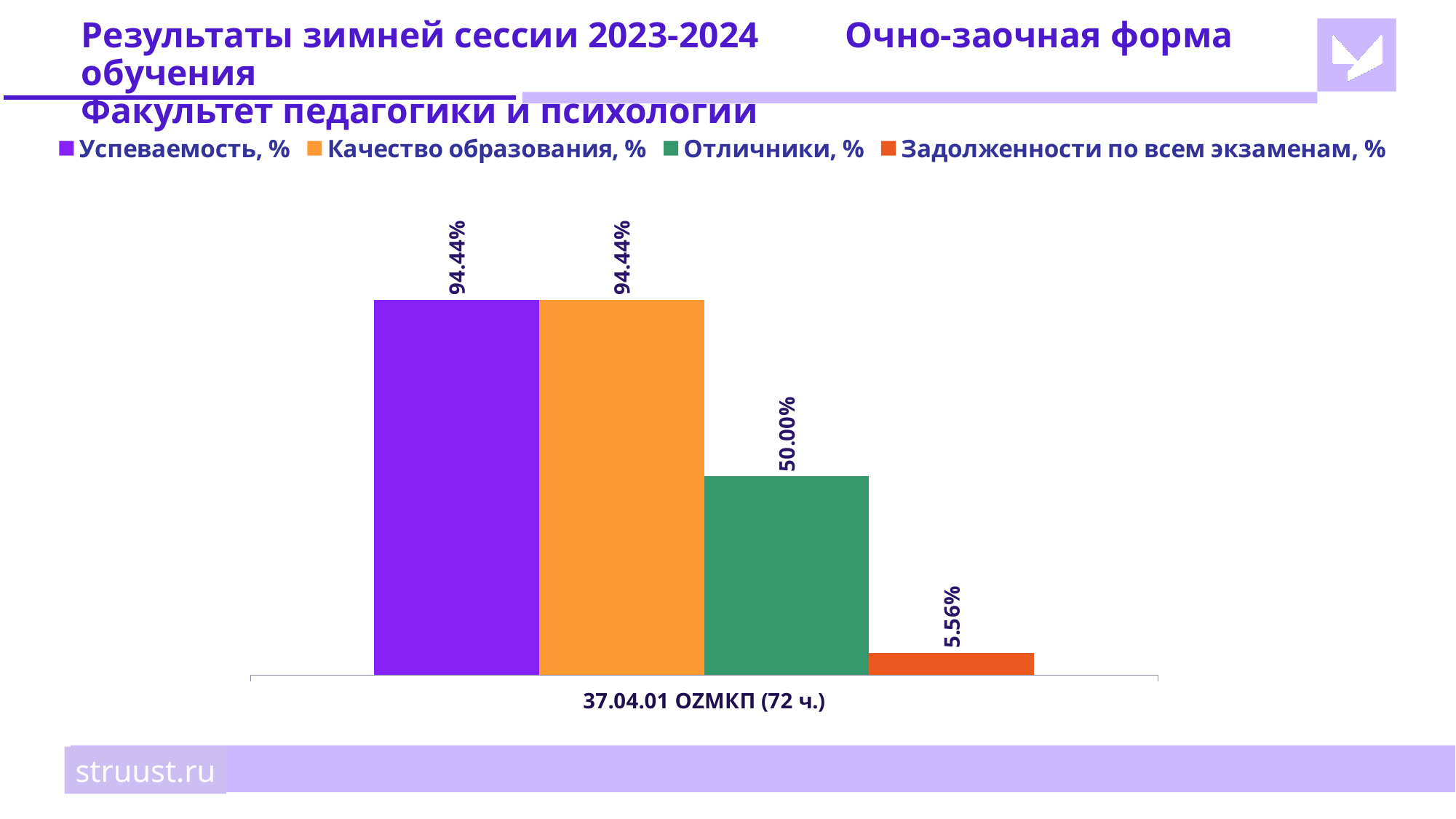
How many categories are shown on the x axis? 1 How many series does the legend list? 4 Which is larger, Отличники, % or Задолженности по всем экзаменам, %? Отличники, % Which series has the lowest value on the chart? Задолженности по всем экзаменам, % What colour is the bar for Отличники, %? green What kind of chart is shown on the slide? bar chart What is the value of Качество образования, % for 37.04.01 OZМКП (72 ч.)? 94.44% What is the value of Задолженности по всем экзаменам, % for 37.04.01 OZМКП (72 ч.)? 5.56% What is the difference between Качество образования, % and Отличники, %? 44.44% What is the value of Успеваемость, % for 37.04.01 OZМКП (72 ч.)? 94.44% What is the value of Отличники, % for 37.04.01 OZМКП (72 ч.)? 50.00% What is the difference between Отличники, % and Задолженности по всем экзаменам, %? 44.44%